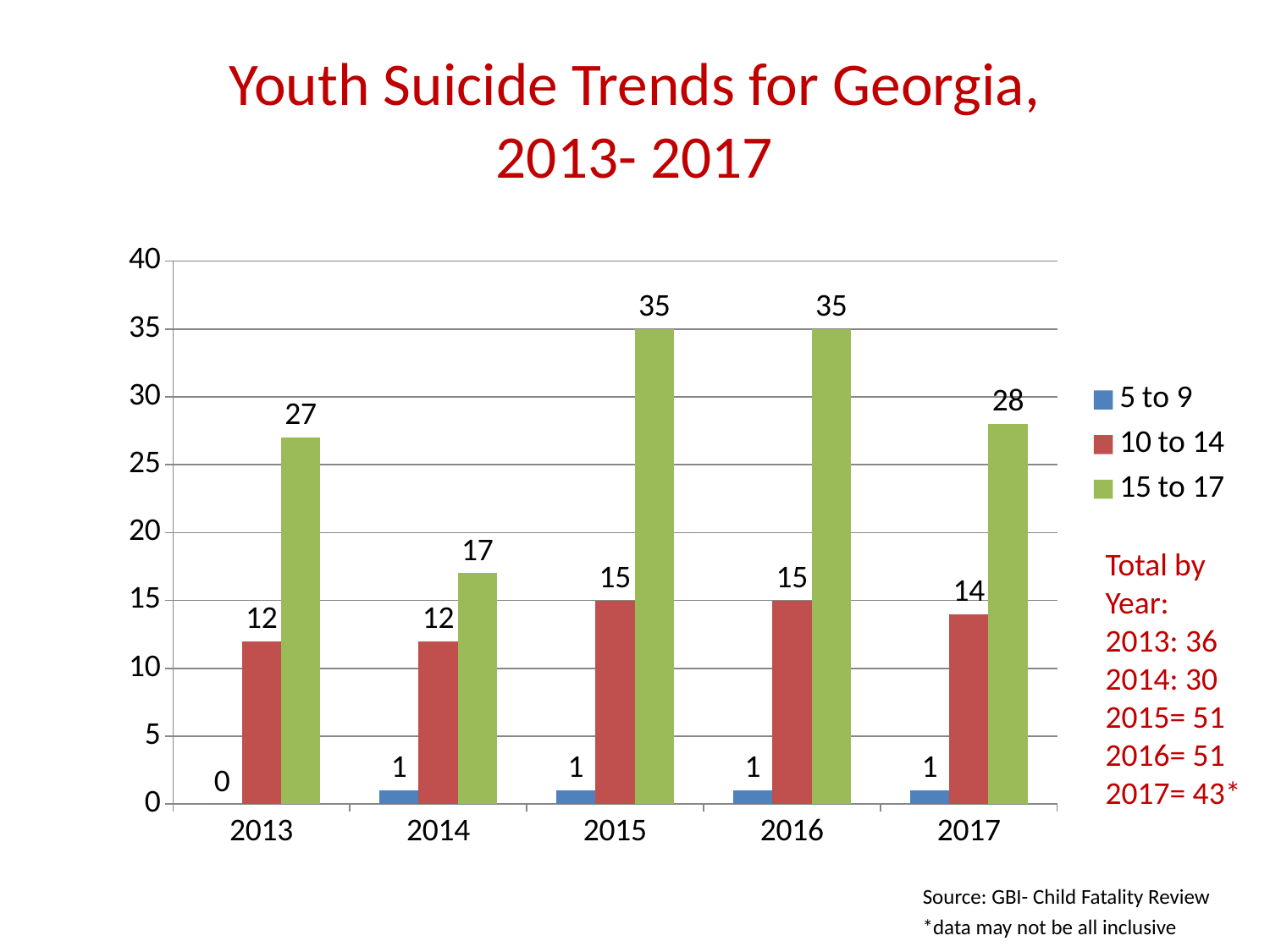
Which is larger: the 15 to 17 value in 2017 or the 15 to 17 value in 2013? 2017 In which year is the 15 to 17 value lowest? 2014 How many series does the legend list? 3 Which colour represents the 5 to 9 age group? Blue What is the value for the 15 to 17 age group in 2013? 27 Does the 10 to 14 value rise or fall from 2014 to 2015? Rise What is the value for the 10 to 14 age group in 2017? 14 How many years are shown on the x axis? 5 What is the value for the 5 to 9 age group in 2013? 0 What is the difference between the 15 to 17 value and the 10 to 14 value in 2015? 20 What kind of chart is shown on the slide? Bar chart What is the title of the chart? Youth Suicide Trends for Georgia, 2013- 2017